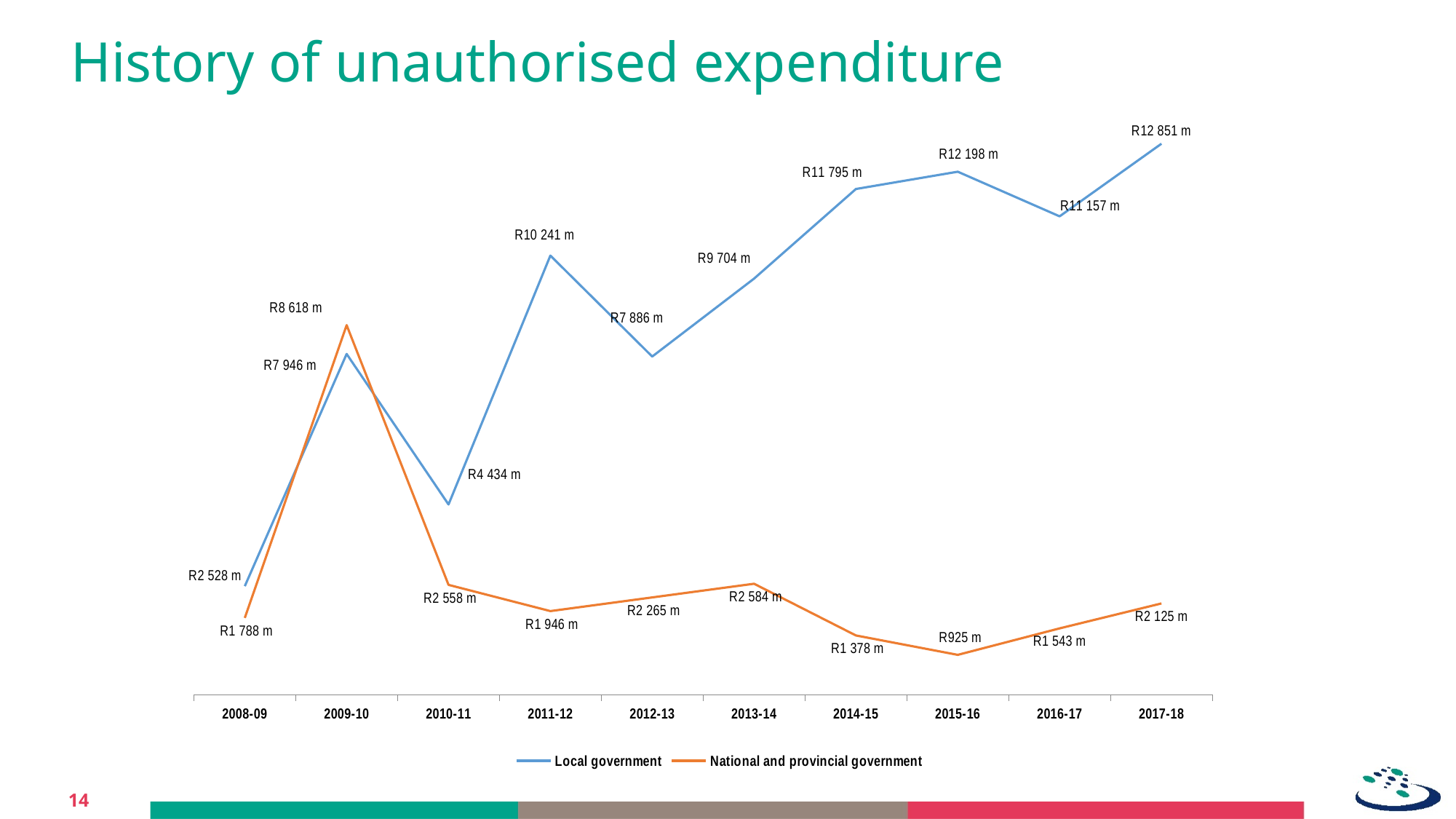
In which year is the Local government value highest? 2017-18 In 2009-10, which series has the higher value: Local government or National and provincial government? National and provincial government What is the National and provincial government value for 2015-16? R925 m What is the difference between the Local government and National and provincial government values in 2017-18? R10 726 m What is the Local government value for 2008-09? R2 528 m In which year is the National and provincial government value lowest? 2015-16 What is the Local government value for 2011-12? R10 241 m In which year is the National and provincial government value highest? 2009-10 How many financial years are shown on the x axis? 10 How many series does the legend list? 2 Which colour is used for the National and provincial government line? Orange What kind of chart is shown on the slide? Line chart